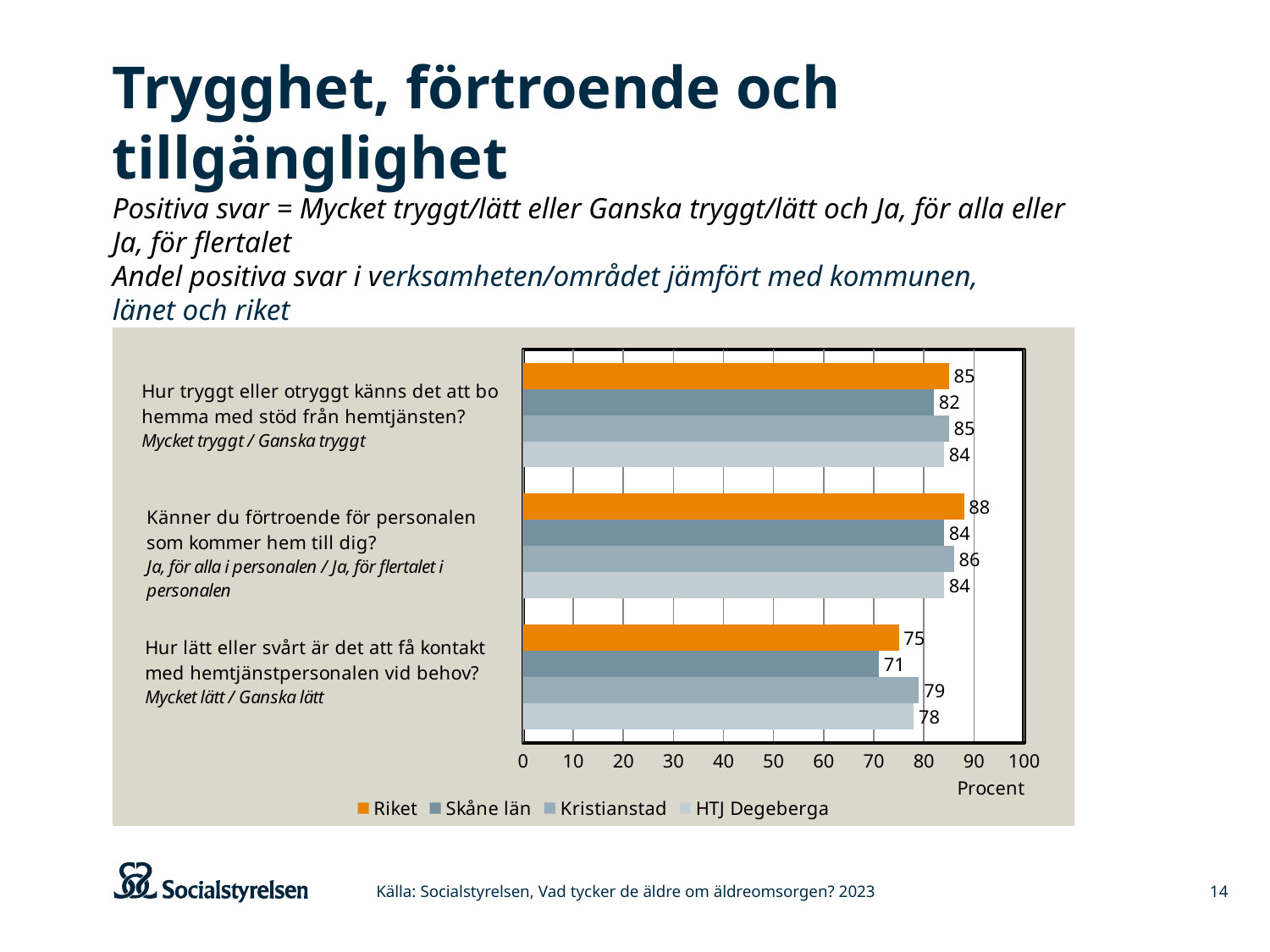
What is the value for Skåne län on the question "Hur tryggt eller otryggt känns det att bo hemma med stöd från hemtjänsten?"? 82 Is the value for Riket on the question "Hur lätt eller svårt är det att få kontakt med hemtjänstpersonalen vid behov?" greater or less than 80? less Which is larger on the question "Känner du förtroende för personalen som kommer hem till dig?": Kristianstad or HTJ Degeberga? Kristianstad What kind of chart is shown on the slide? Bar chart What is the value for Riket on the question "Känner du förtroende för personalen som kommer hem till dig?"? 88 How many question categories are plotted on the chart? 3 How many series does the legend list? 4 What colour are the bars for Riket in the chart? Orange Which series has the highest value on the question "Känner du förtroende för personalen som kommer hem till dig?"? Riket Which series has the lowest value on the question "Hur lätt eller svårt är det att få kontakt med hemtjänstpersonalen vid behov?"? Skåne län What is the difference between Kristianstad and Skåne län on the question "Hur lätt eller svårt är det att få kontakt med hemtjänstpersonalen vid behov?"? 8 What is the value for HTJ Degeberga on the question "Hur lätt eller svårt är det att få kontakt med hemtjänstpersonalen vid behov?"? 78